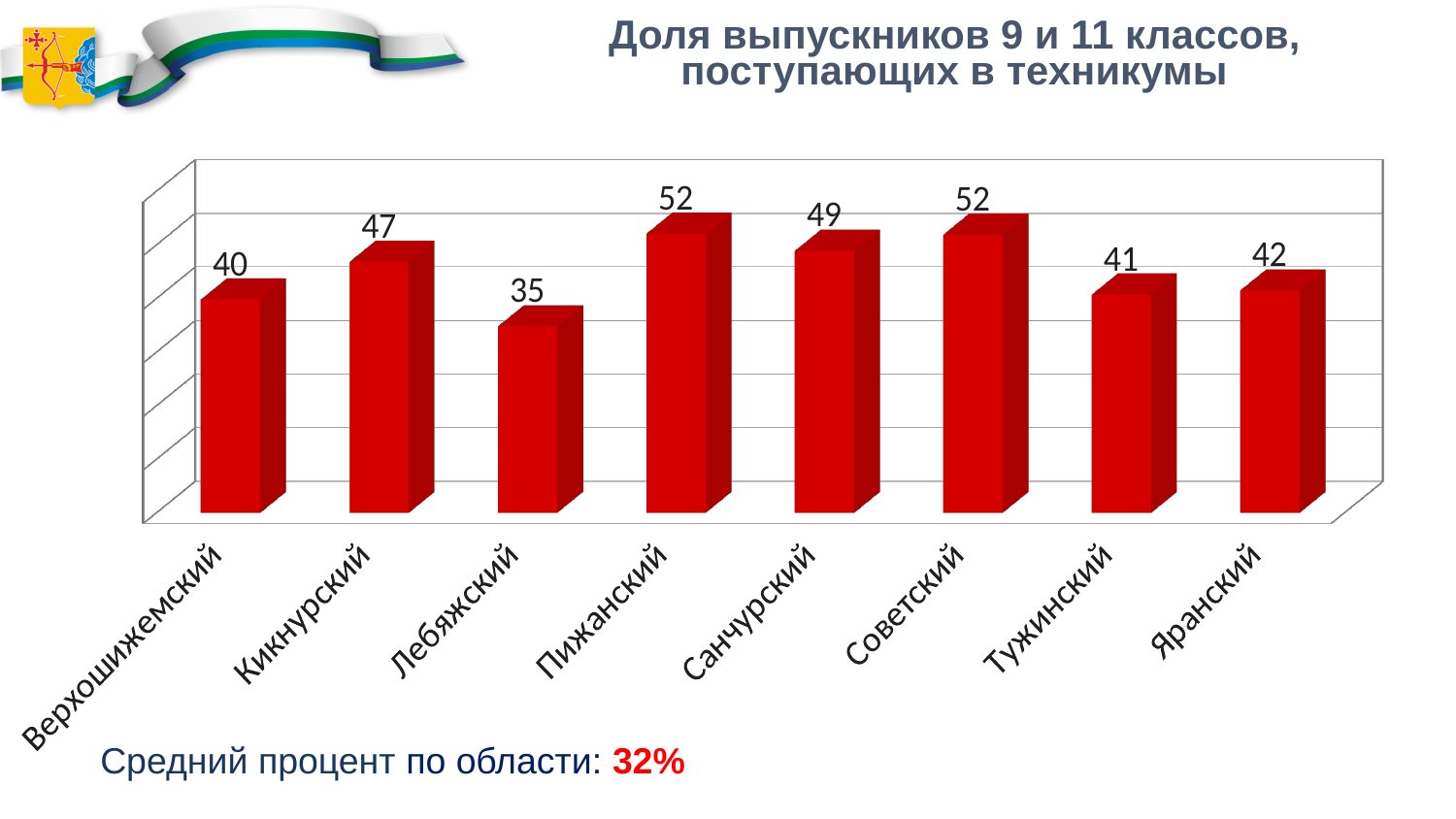
Which is larger, the value for Санчурский or the value for Яранский? Санчурский What kind of chart is shown on the slide? bar chart What is the value for Кикнурский? 47 Which category has the lowest value? Лебяжский What is the value for Яранский? 42 What is the difference between the values for Кикнурский and Тужинский? 6 What is the average percentage for the region stated below the chart? 32% What is the difference between the values for Пижанский and Лебяжский? 17 What is the value for Верхошижемский? 40 Which is larger, the value for Верхошижемский or the value for Тужинский? Тужинский How many categories are shown in the chart? 8 What is the value for Санчурский? 49